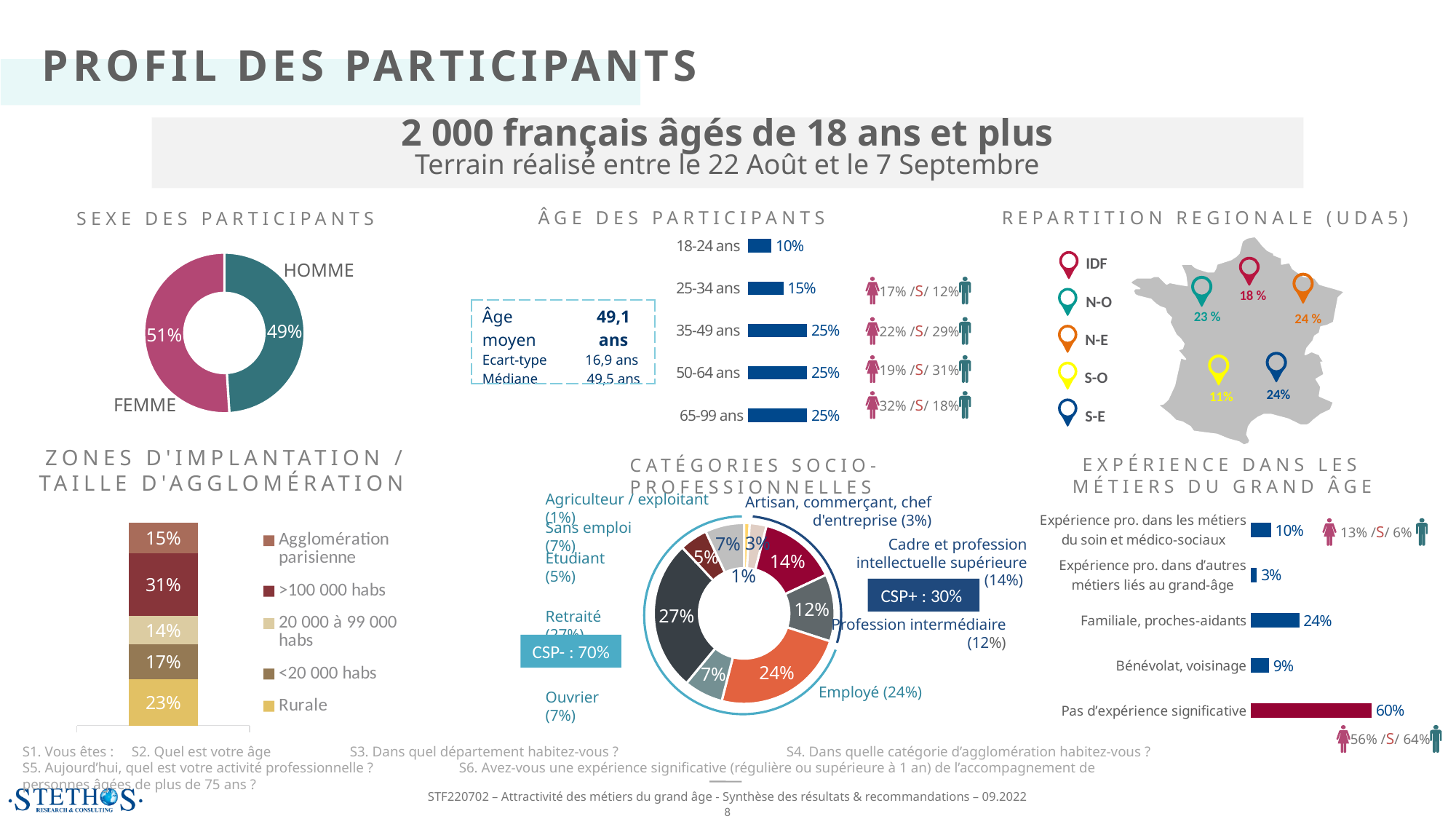
In the 'Sexe des participants' chart, what share of participants are women (FEMME)? 51% What kind of chart is used for 'Sexe des participants'? Donut (pie) chart In the 'Âge des participants' chart, what is the value for 18-24 ans? 10% In the 'Catégories socio-professionnelles' chart, what is the share for Retraité? 27% In the 'Expérience dans les métiers du grand âge' chart, which is larger: 'Familiale, proches-aidants' or 'Bénévolat, voisinage'? Familiale, proches-aidants In the 'Âge des participants' chart, what is the difference between the 35-49 ans value and the 25-34 ans value? 10% In the 'Âge des participants' chart, how many age groups are shown? 5 In the 'Âge des participants' chart, which age group has the lowest share? 18-24 ans In the 'Expérience dans les métiers du grand âge' chart, what is the value for 'Pas d'expérience significative'? 60% In the 'Catégories socio-professionnelles' chart, which category has the smallest share? Agriculteur / exploitant In the 'Zones d'implantation / taille d'agglomération' stacked bar, what is the value for '>100 000 habs'? 31% In the 'Zones d'implantation / taille d'agglomération' chart, which category has the largest share? >100 000 habs